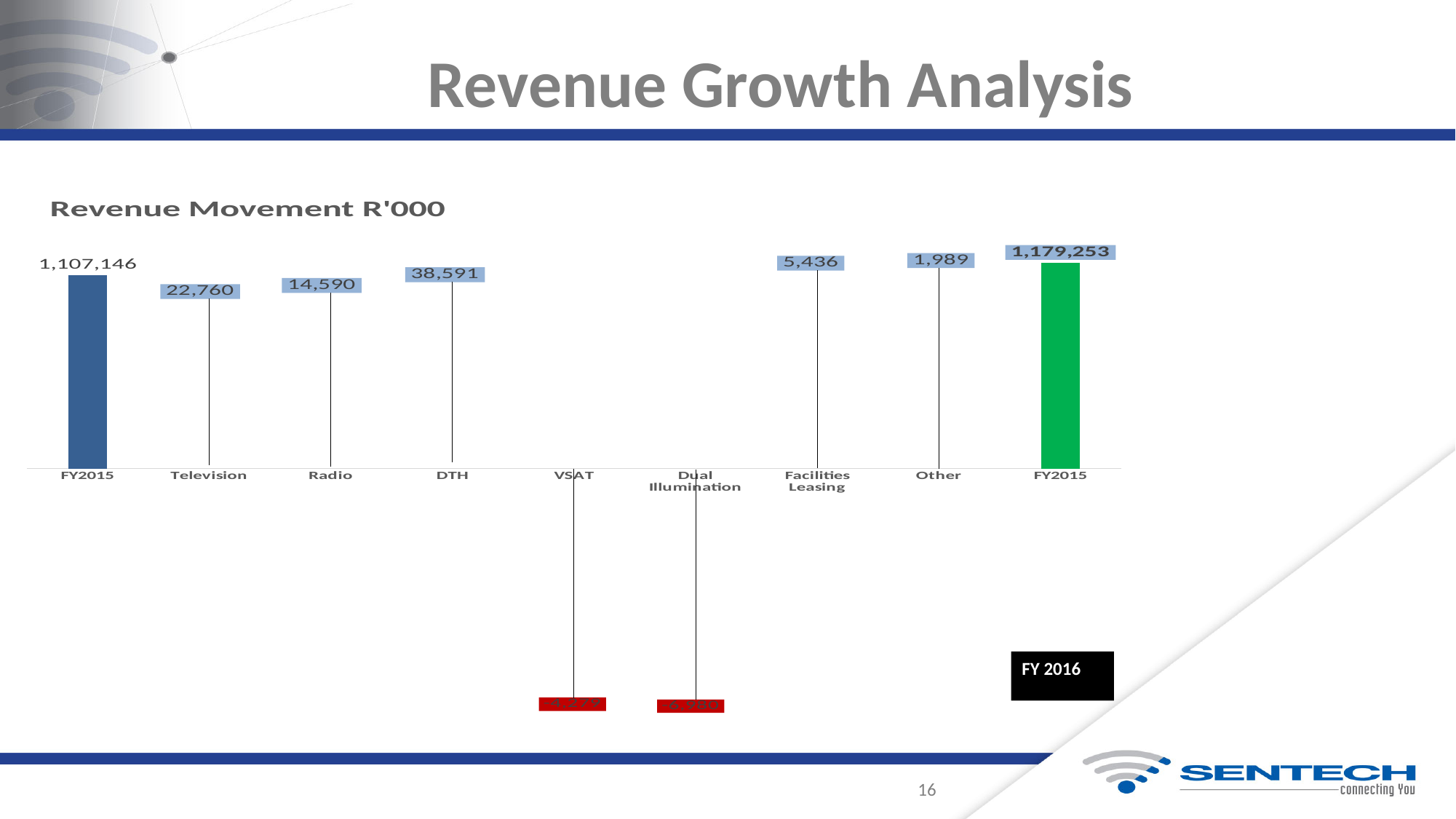
What is the value shown for Facilities Leasing? 5,436 What is the title of the chart? Revenue Movement R'000 What is the value shown for Radio? 14,590 What is the value shown for Other? 1,989 What is the value shown for Television? 22,760 What is the difference between the DTH value and the Television value? 15,831 How many categories are shown along the x axis? 9 What is the value shown for the first FY2015 bar? 1,107,146 Which of the revenue movement categories (Television, Radio, DTH, Facilities Leasing, Other) has the largest positive value? DTH What is the value shown for the final green bar on the right? 1,179,253 What is the value shown for DTH? 38,591 Which is larger, the value for Radio or the value for Facilities Leasing? Radio